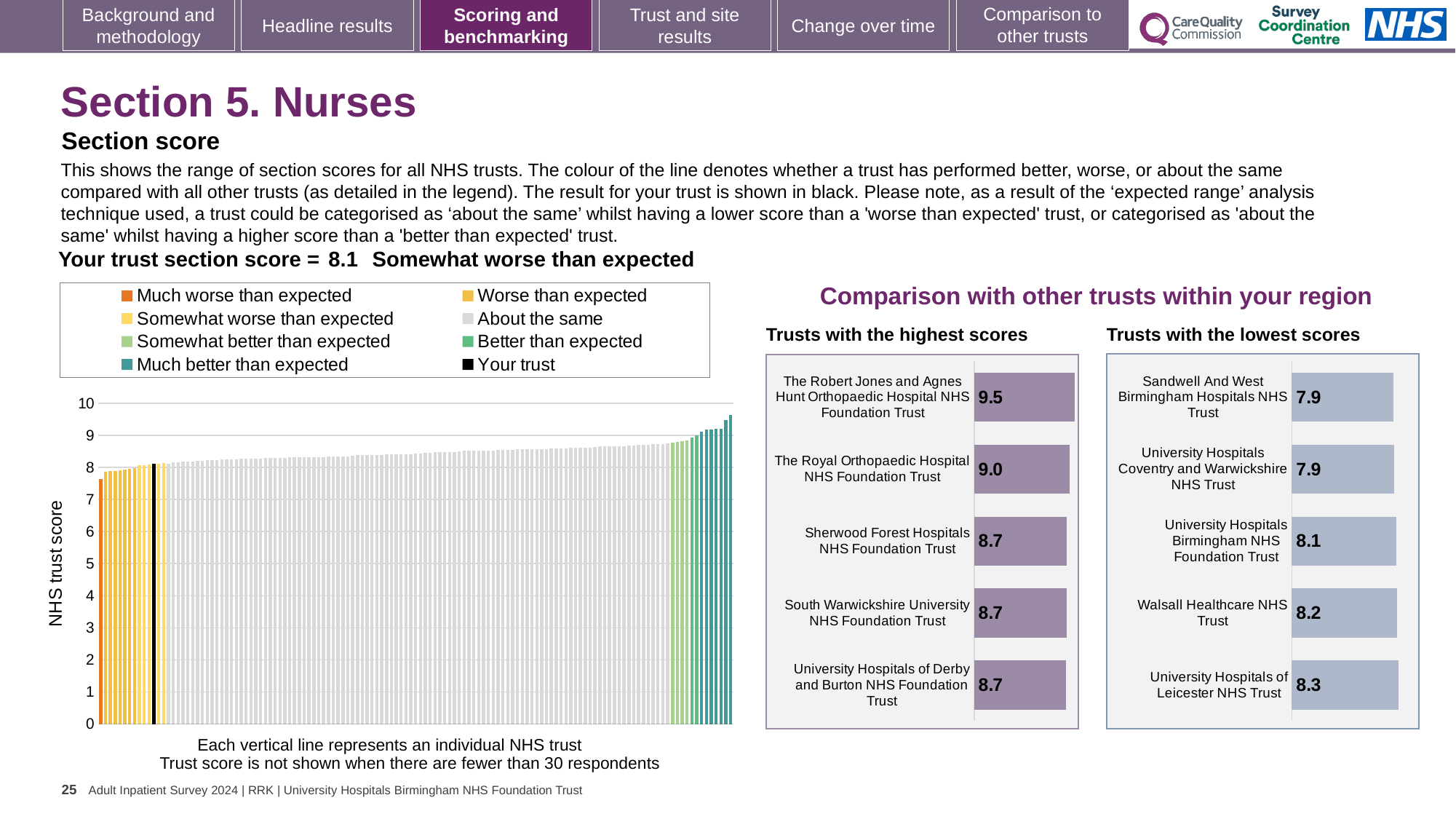
In the 'Trusts with the highest scores' chart, how many trusts are listed? 5 In the 'Trusts with the highest scores' chart, what is the difference between the scores of The Robert Jones and Agnes Hunt Orthopaedic Hospital NHS Foundation Trust and The Royal Orthopaedic Hospital NHS Foundation Trust? 0.5 In the 'Trusts with the lowest scores' chart, which trust has the highest score? University Hospitals of Leicester NHS Trust What is the section score for your trust shown on the slide? 8.1 In the 'Trusts with the lowest scores' chart, what is the score for Walsall Healthcare NHS Trust? 8.2 In the 'Trusts with the highest scores' chart, what is the score for The Royal Orthopaedic Hospital NHS Foundation Trust? 9.0 In the 'Trusts with the highest scores' chart, which trust has the highest score? The Robert Jones and Agnes Hunt Orthopaedic Hospital NHS Foundation Trust In the large chart on the left, do the trust scores rise or fall from left to right? rise In the large chart on the left, what is the highest value shown on the NHS trust score axis? 10 In the 'Trusts with the lowest scores' chart, which is larger: the score for University Hospitals Birmingham NHS Foundation Trust or the score for University Hospitals of Leicester NHS Trust? University Hospitals of Leicester NHS Trust What kind of chart is the large chart on the left showing NHS trust scores? bar chart In the large chart on the left, how many entries does the legend list? 8